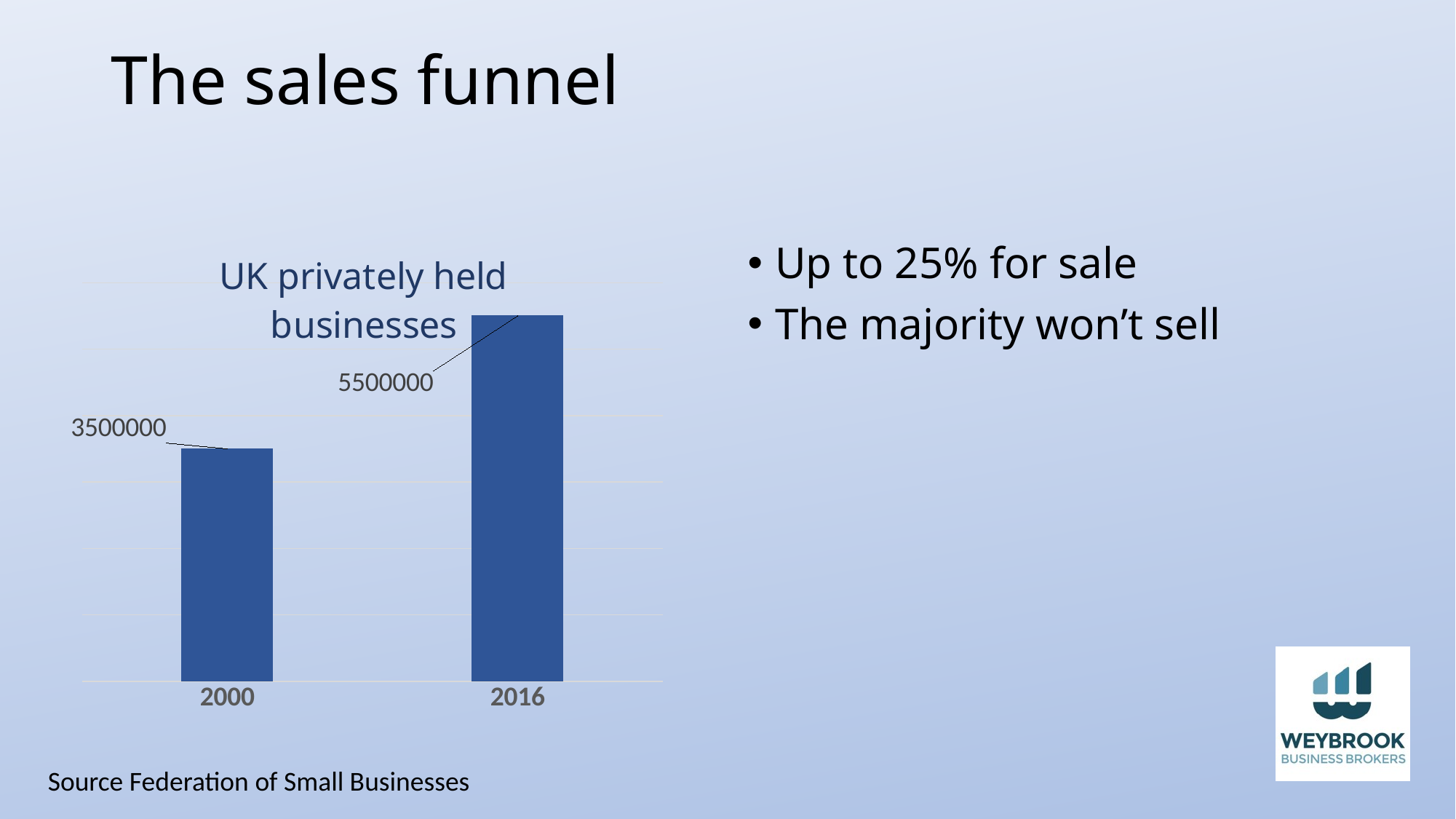
Which year has the lower value in the UK privately held businesses chart? 2000 Which year has the higher value in the UK privately held businesses chart? 2016 What is the difference between the 2016 and 2000 values in the UK privately held businesses chart? 2000000 What kind of chart is the UK privately held businesses chart? bar chart What is the value for 2016 in the UK privately held businesses chart? 5500000 Do the values rise or fall from 2000 to 2016 in the UK privately held businesses chart? rise What source is cited for the chart on the slide? Federation of Small Businesses What is the value for 2000 in the UK privately held businesses chart? 3500000 Is the value for 2016 larger or smaller than the value for 2000 in the UK privately held businesses chart? larger What is the title of the chart on the slide? UK privately held businesses How many categories are shown on the x axis of the UK privately held businesses chart? 2